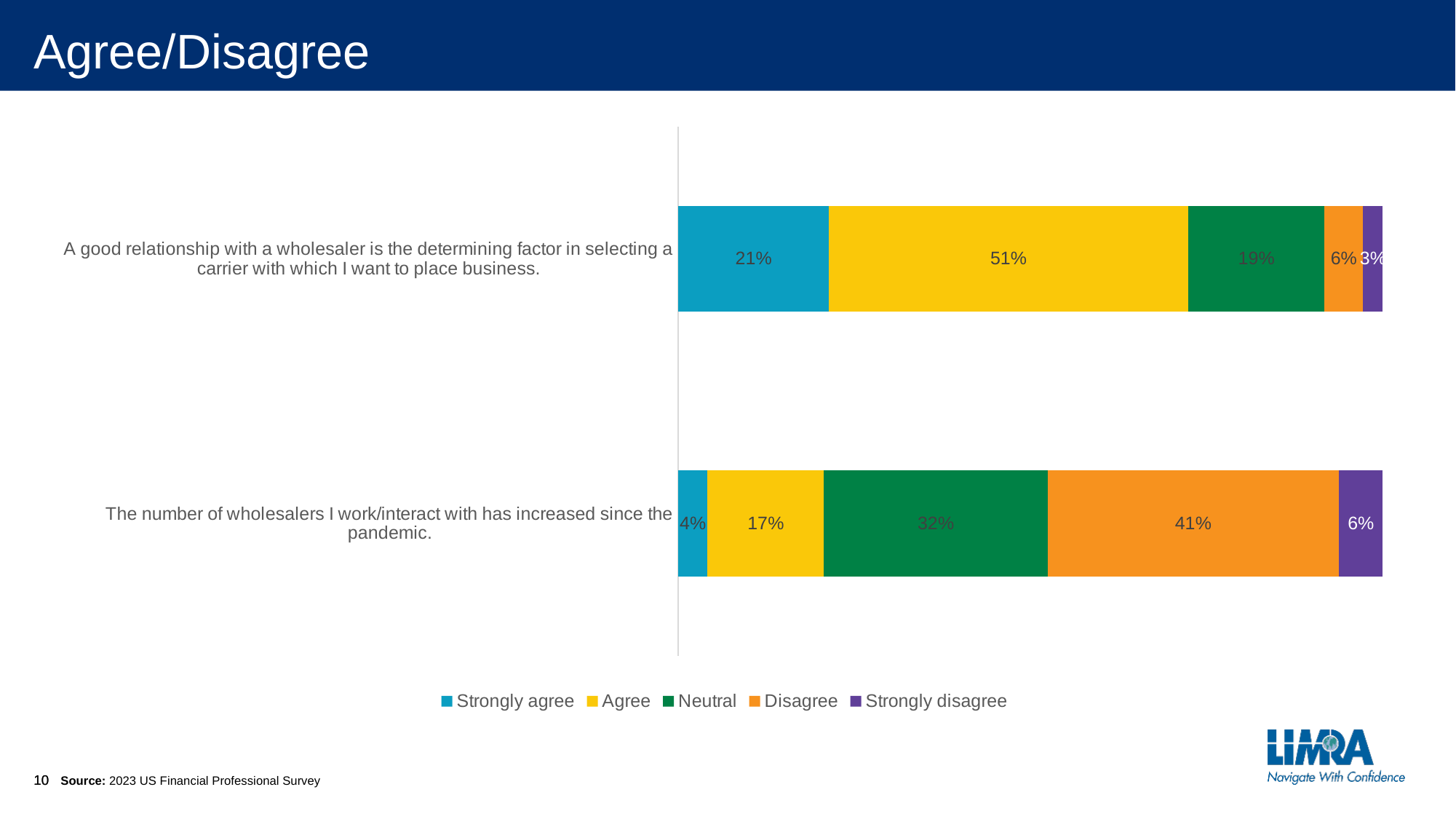
What percentage of respondents are neutral on the statement that the number of wholesalers they work/interact with has increased since the pandemic? 32% What is the difference between the Agree percentages for the two statements? 34% Which response category has the largest share for the statement about the number of wholesalers increasing since the pandemic? Disagree What percentage of respondents disagree that the number of wholesalers they work/interact with has increased since the pandemic? 41% What percentage of respondents strongly agree that a good relationship with a wholesaler is the determining factor in selecting a carrier? 21% What percentage of respondents strongly disagree that a good relationship with a wholesaler is the determining factor in selecting a carrier? 3% Which response category has the smallest share for the statement about a good relationship with a wholesaler being the determining factor? Strongly disagree How many response categories does the legend list? 5 What percentage of respondents agree that a good relationship with a wholesaler is the determining factor in selecting a carrier? 51% What type of chart is shown on the slide? Stacked bar chart How many statements are shown in the chart? 2 Which statement has a higher Neutral percentage? The number of wholesalers I work/interact with has increased since the pandemic.